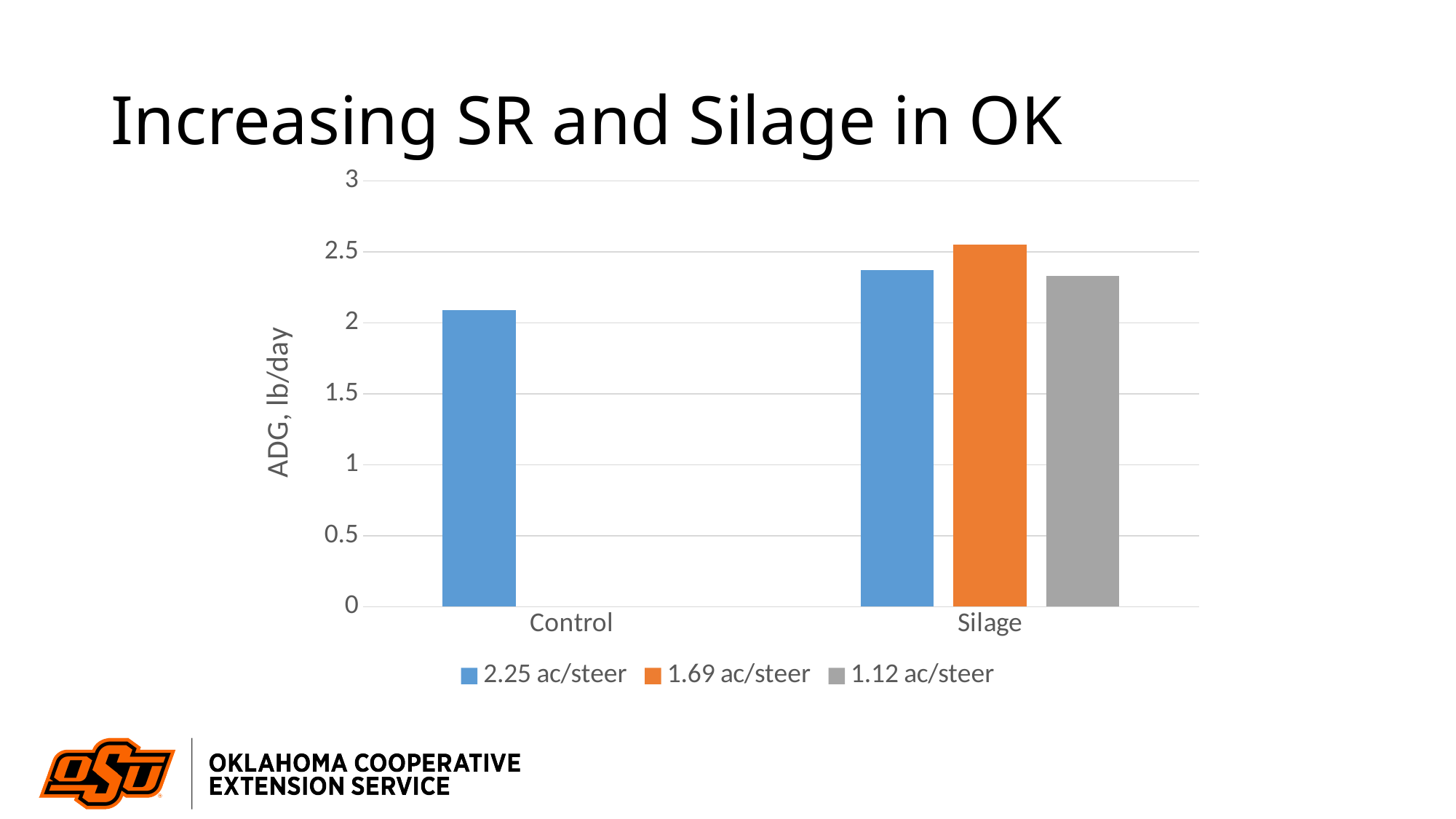
How many categories are shown on the x axis? 2 What is the label on the vertical axis? ADG, lb/day Is the 1.12 ac/steer value for Silage greater or less than 2.5? less Is the 2.25 ac/steer value for Silage greater or less than 2.5? less What kind of chart is shown on the slide? bar chart Which category has bars for only one series? Control Which is larger, the 2.25 ac/steer value for Control or the 2.25 ac/steer value for Silage? Silage Is the 2.25 ac/steer value for Control greater or less than 2? greater What is the title of the chart? Increasing SR and Silage in OK Within the Silage category, which series has the highest bar? 1.69 ac/steer How many series does the legend list? 3